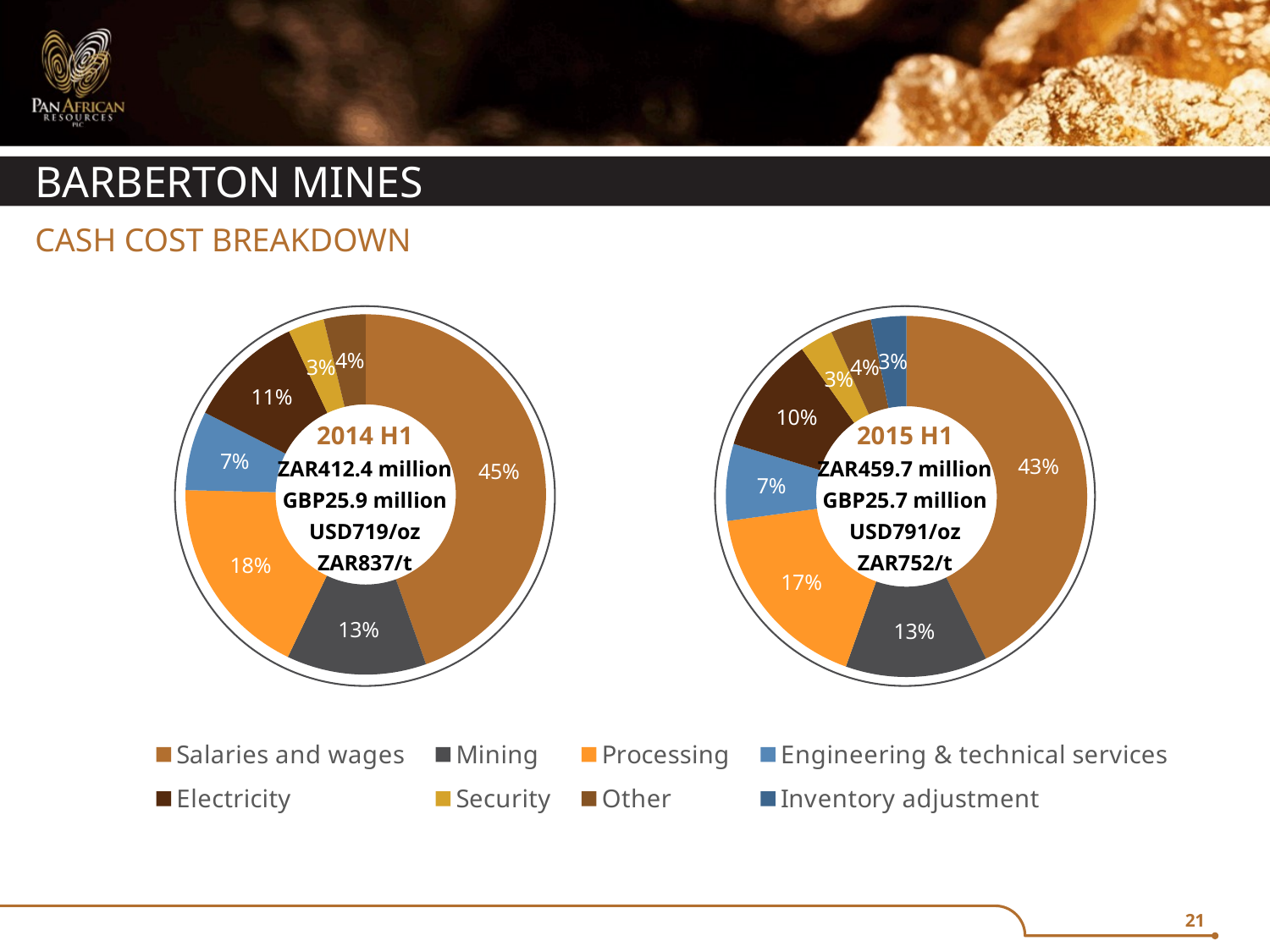
What total cash cost in ZAR is shown in the centre of the 2015 H1 chart? ZAR459.7 million What kind of chart is used to show the cash cost breakdown? Doughnut (pie) chart How many categories does the legend list? 8 In the 2015 H1 chart, what share of cash cost is Inventory adjustment? 3% What is the difference between the Salaries and wages share in 2014 H1 and in 2015 H1? 2 percentage points In the 2014 H1 chart, which category has the largest share? Salaries and wages In the 2015 H1 chart, which is larger: the Electricity share or the Engineering & technical services share? Electricity In the 2014 H1 chart, what share of cash cost is Salaries and wages? 45% How many labelled slices does the 2015 H1 chart have? 8 In the 2015 H1 chart, what share of cash cost is Processing? 17% In the 2014 H1 chart, which category has the smallest share? Security What cost per ounce in USD is shown in the centre of the 2014 H1 chart? USD719/oz